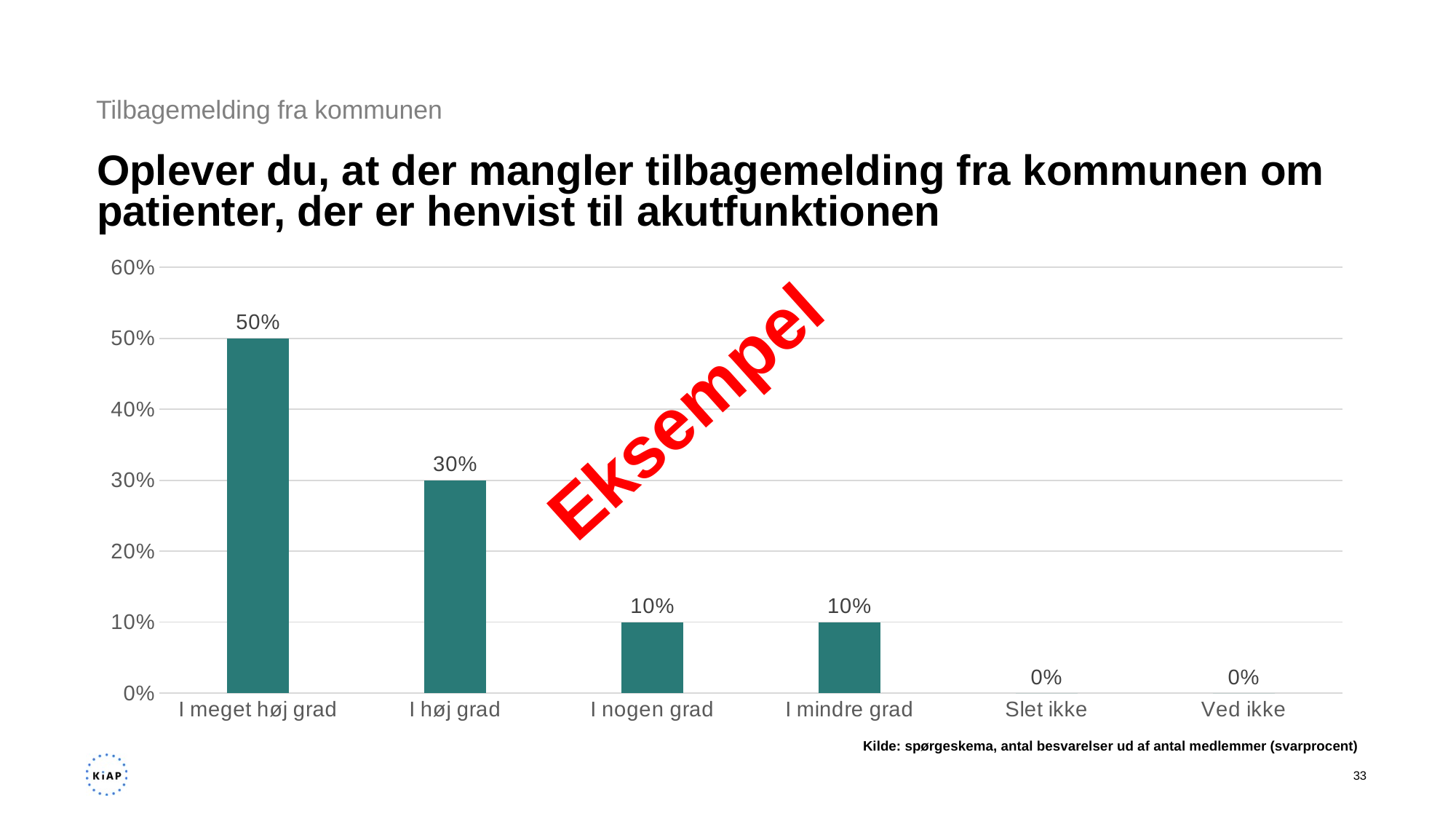
What kind of chart is shown on the slide? bar chart What is the value for "Slet ikke"? 0% How many categories are shown on the x axis? 6 What is the value for "I høj grad"? 30% What is the red diagonal text overlaid on the chart? Eksempel Which is larger, the value for "I høj grad" or the value for "I nogen grad"? I høj grad What is the value for "I meget høj grad"? 50% What is the value for "I nogen grad"? 10% Which category has the highest value? I meget høj grad What is the difference between the values for "I høj grad" and "I mindre grad"? 20% What is the difference between the values for "I meget høj grad" and "I høj grad"? 20% Is the value for "I meget høj grad" greater or less than 40%? greater